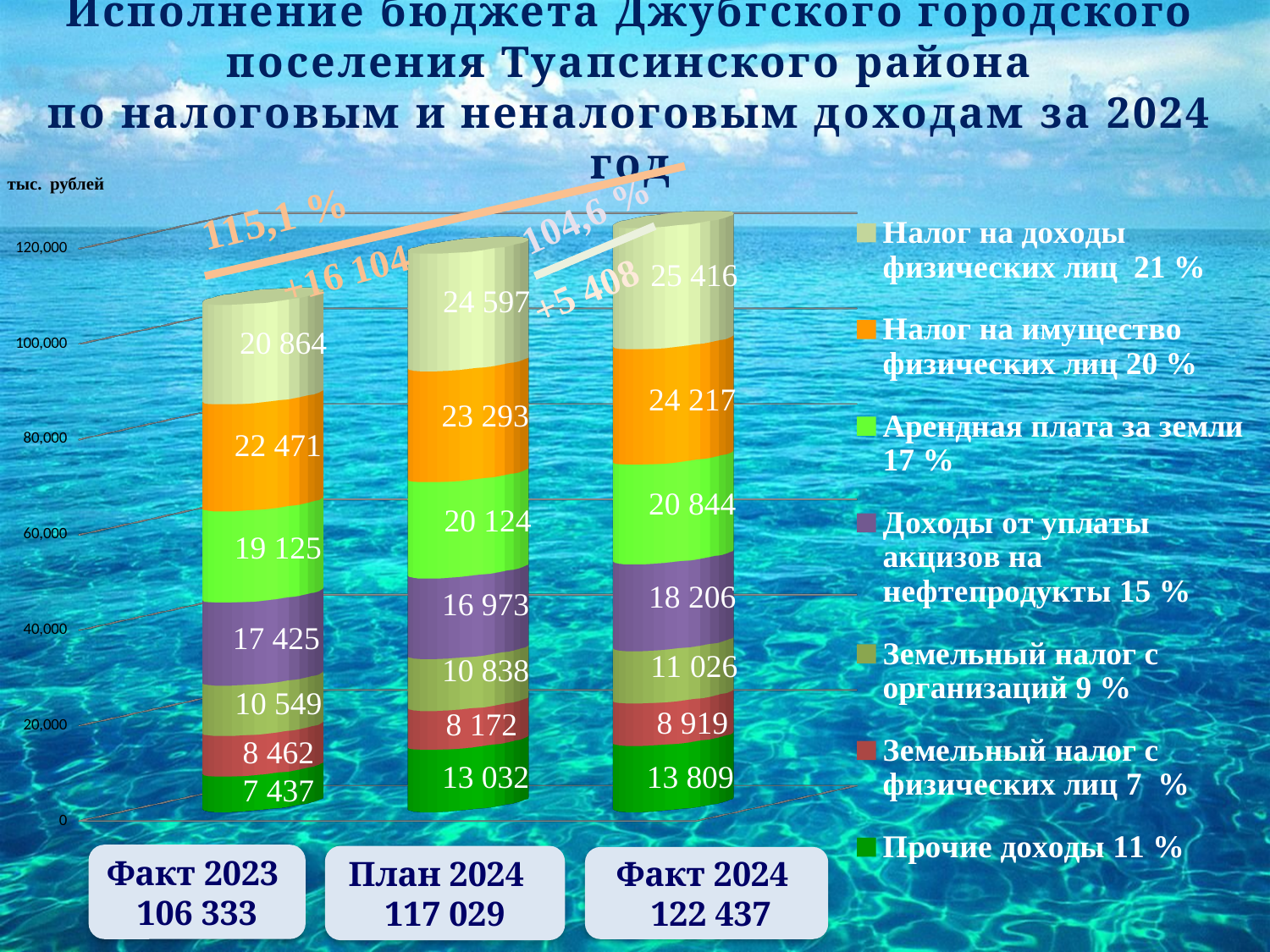
Which bar has the highest total? Факт 2024 Which is larger for Земельный налог с организаций: План 2024 or Факт 2024? Факт 2024 How many bars (categories) are shown in the chart? 3 What is the value of Арендная плата за земли for План 2024? 20 124 What is the difference between Налог на имущество физических лиц for Факт 2024 and for Факт 2023? 1 746 What is the value of Прочие доходы for Факт 2023? 7 437 What is the value of Налог на доходы физических лиц for Факт 2024? 25 416 What is the value of Доходы от уплаты акцизов на нефтепродукты for Факт 2023? 17 425 What kind of chart is shown on the slide? Stacked bar chart What is the difference between Прочие доходы for Факт 2024 and for План 2024? 777 What is the total of the stacked bar for Факт 2024? 122 437 How many series does the legend list? 7